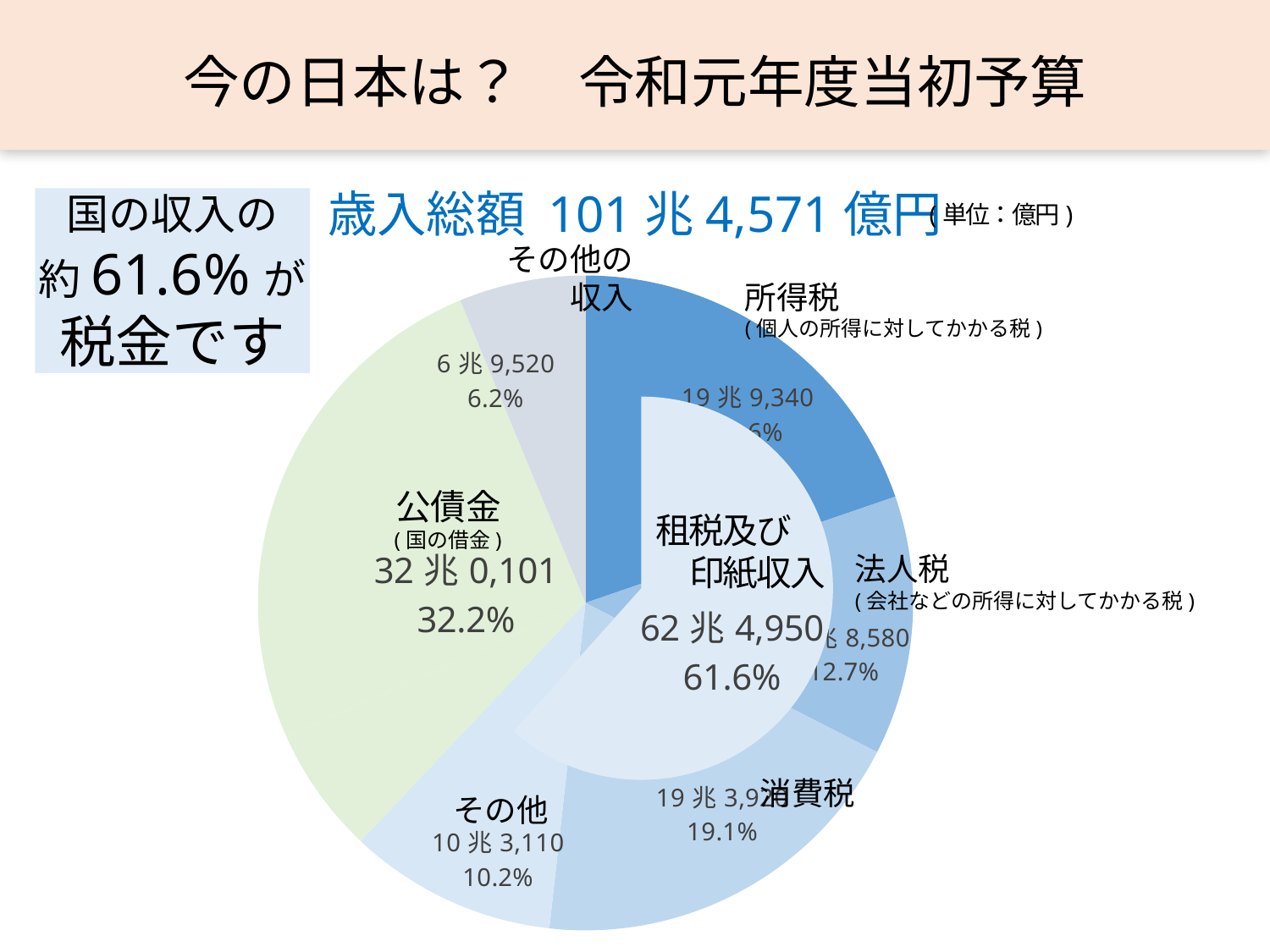
Which is larger in the pie chart, the share of 公債金 or the share of その他? 公債金 What is the value shown for 租税及び印紙収入 in the pie chart? 62兆4,950 What total revenue amount (歳入総額) is stated above the pie chart? 101兆4,571億円 What percentage share does 公債金 have in the pie chart? 32.2% What percentage share does 法人税 have in the pie chart? 12.7% What kind of chart is shown on the slide? pie chart What is the value shown for その他の収入 in the pie chart? 6兆9,520 What is the value shown for その他 in the pie chart? 10兆3,110 What percentage share does その他の収入 have in the pie chart? 6.2% What is the difference in percentage share between 消費税 and 法人税 in the pie chart? 6.4% What is the value shown for 公債金 in the pie chart? 32兆0,101